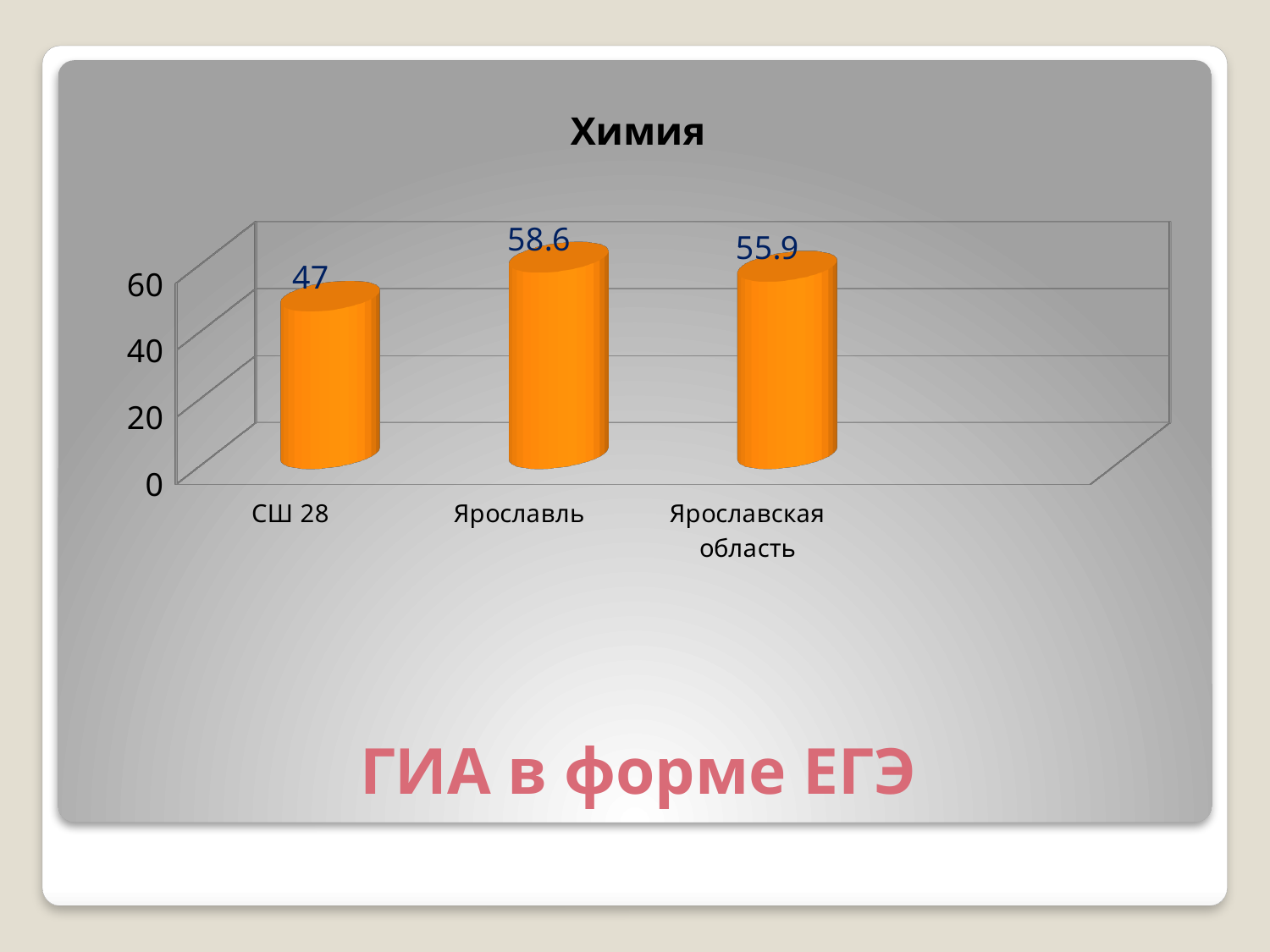
What is the value for Ярославль? 58.6 What is the value for Ярославская область? 55.9 Which is larger, the value for Ярославская область or the value for СШ 28? Ярославская область Which category has the highest value? Ярославль What is the difference between the values for Ярославль and СШ 28? 11.6 Which category has the lowest value? СШ 28 What kind of chart is shown on the slide? bar chart How many categories are shown on the chart? 3 What is the difference between the values for Ярославль and Ярославская область? 2.7 What is the title of the chart? Химия What is the value for СШ 28? 47 Is the value for СШ 28 greater or less than 40? greater